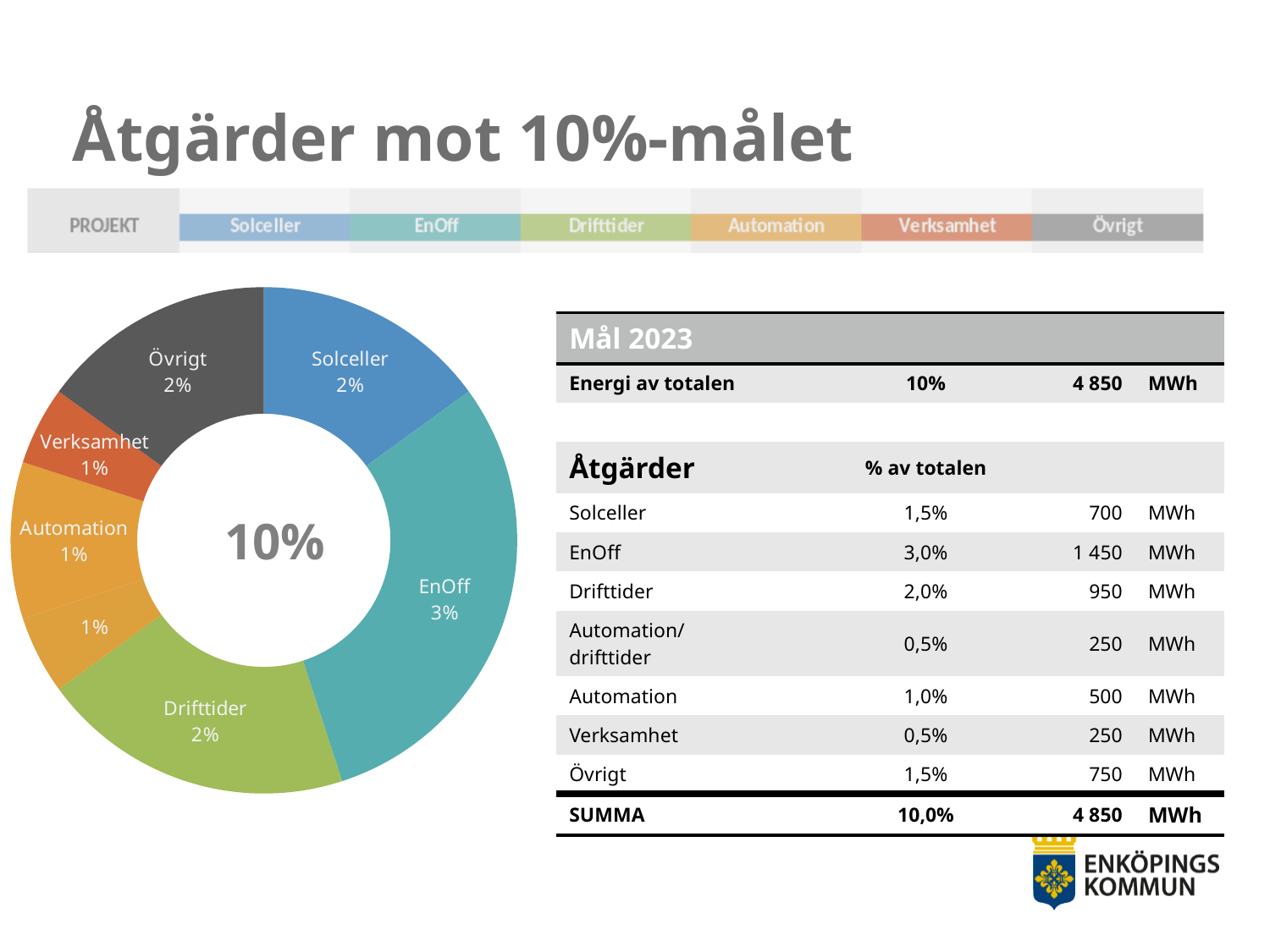
What percentage is shown for EnOff in the pie chart? 3% What percentage is shown for Automation in the pie chart? 1% How many slices does the pie chart have? 7 Which slice of the pie chart is the largest? EnOff What value is printed in the centre of the donut chart? 10% What percentage is shown for Solceller in the pie chart? 2% What percentage is shown for Verksamhet in the pie chart? 1% What percentage is shown for Övrigt in the pie chart? 2% What percentage is shown for Drifttider in the pie chart? 2% Which is larger in the pie chart, EnOff or Drifttider? EnOff What is the difference between the EnOff and Verksamhet percentages in the pie chart? 2% What kind of chart is shown on the left of the slide? Pie chart (donut)